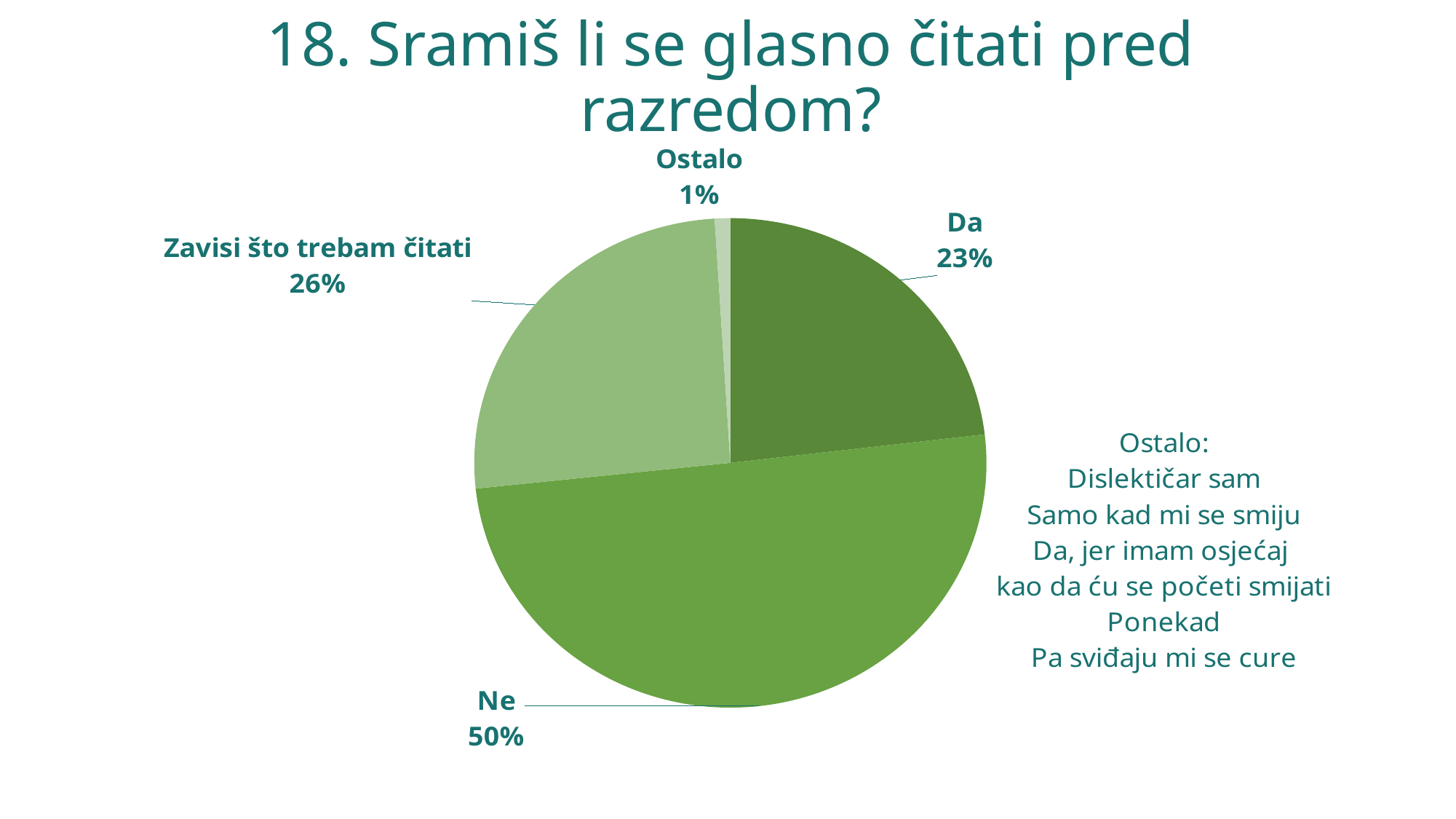
Which category has the largest slice of the pie? Ne What share of the pie does "Ostalo" have? 1% What is the difference in percentage points between "Ne" and "Da"? 27 How many slices does the pie chart have? 4 Which is larger, the slice for "Zavisi što trebam čitati" or the slice for "Da"? Zavisi što trebam čitati What type of chart is shown on the slide? pie chart Which category has the smallest slice of the pie? Ostalo What share of the pie does "Da" have? 23% What is the title of the chart? 18. Sramiš li se glasno čitati pred razredom? What is the difference in percentage points between "Zavisi što trebam čitati" and "Ostalo"? 25 What share of the pie does "Zavisi što trebam čitati" have? 26%